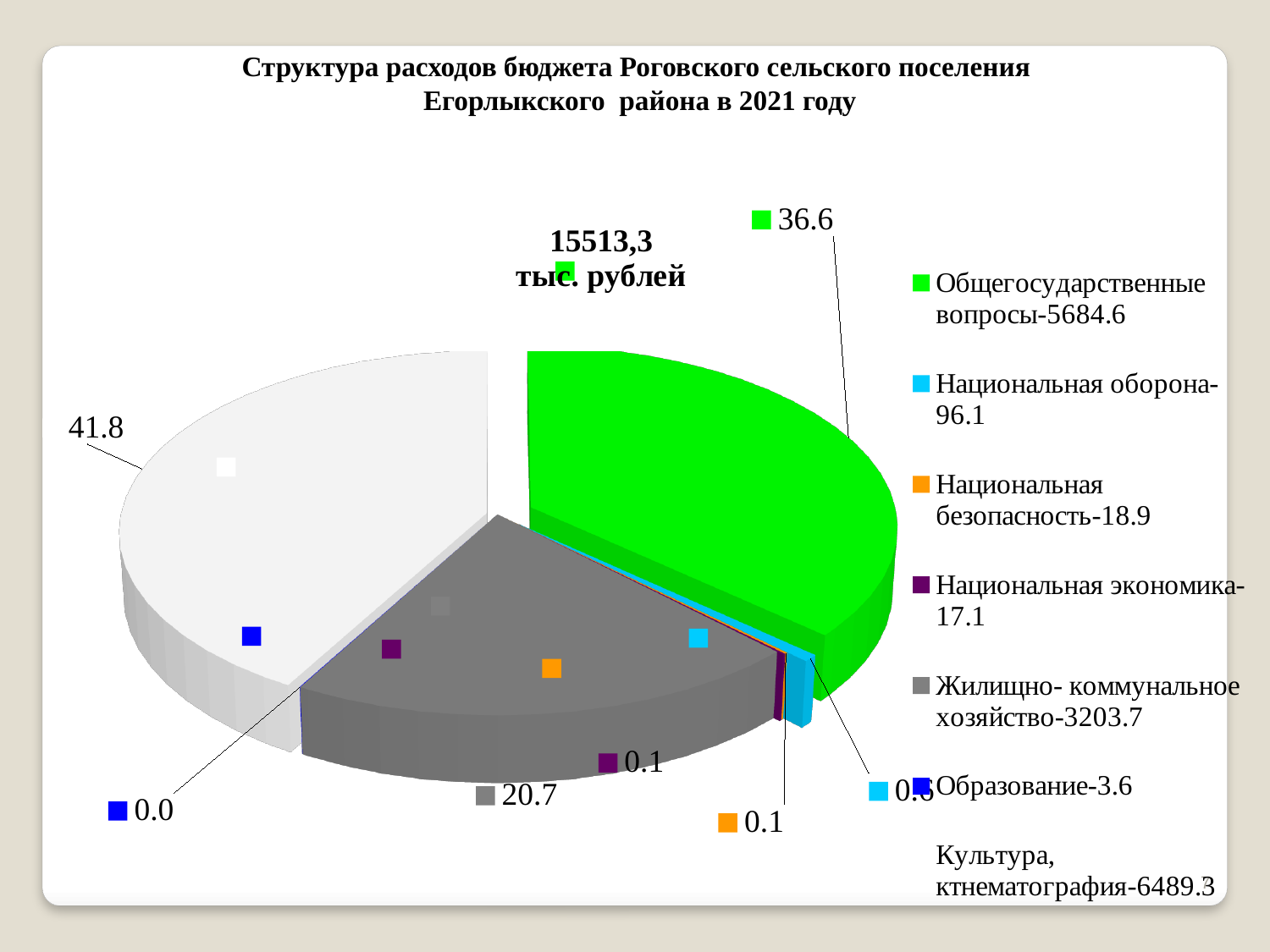
Which category has the smallest share of the pie? Образование What is the difference in percentage points between the Культура, кинематография slice (41.8) and the Общегосударственные вопросы slice (36.6)? 5.2 Which category has the largest share of the pie? Культура, кинематография What percentage label is shown for the Культура, кинематография slice? 41.8 What amount is given in the legend for Национальная оборона? 96.1 How many categories does the legend list? 7 What amount is given in the legend for Жилищно-коммунальное хозяйство? 3203.7 What percentage label is shown for the Общегосударственные вопросы slice? 36.6 What total amount is printed on the chart? 15513,3 тыс. рублей What percentage label is shown for the Жилищно-коммунальное хозяйство slice? 20.7 What kind of chart is shown on the slide? pie chart Which is larger: the share for Общегосударственные вопросы or the share for Жилищно-коммунальное хозяйство? Общегосударственные вопросы